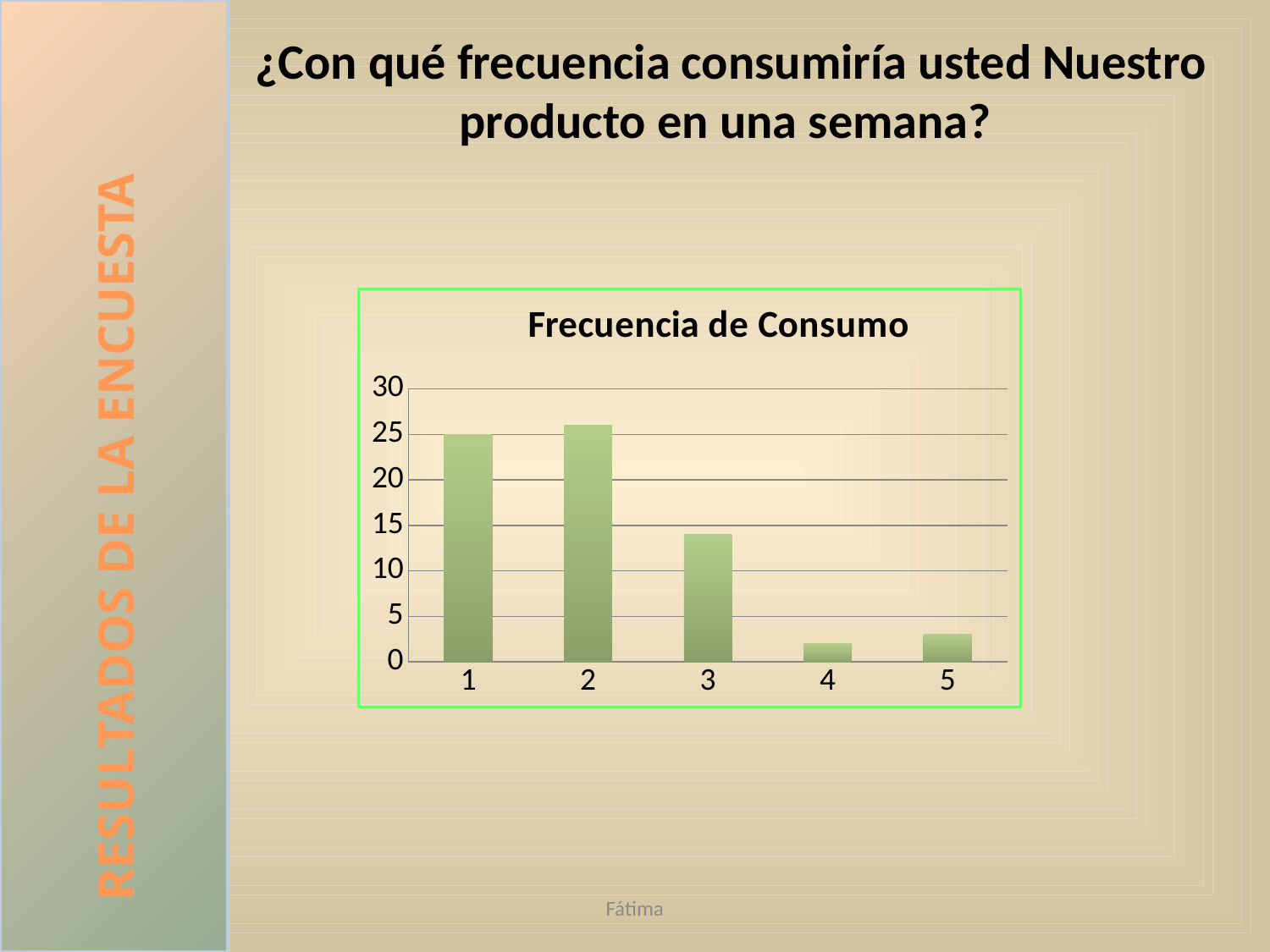
Which category has the lowest bar in the chart? 4 Is the value for category 3 greater or less than 15? less Is the value for category 4 greater or less than 5? less Is the value for category 3 greater or less than 10? greater What is the value for category 1 in the chart? 25 Which category has the highest bar in the chart? 2 What is the title of the chart? Frecuencia de Consumo What type of chart is shown on the slide? bar chart How many categories are shown on the x axis of the chart? 5 Which is larger, the value for category 1 or the value for category 3? category 1 Do the values generally rise or fall from category 1 to category 5? fall